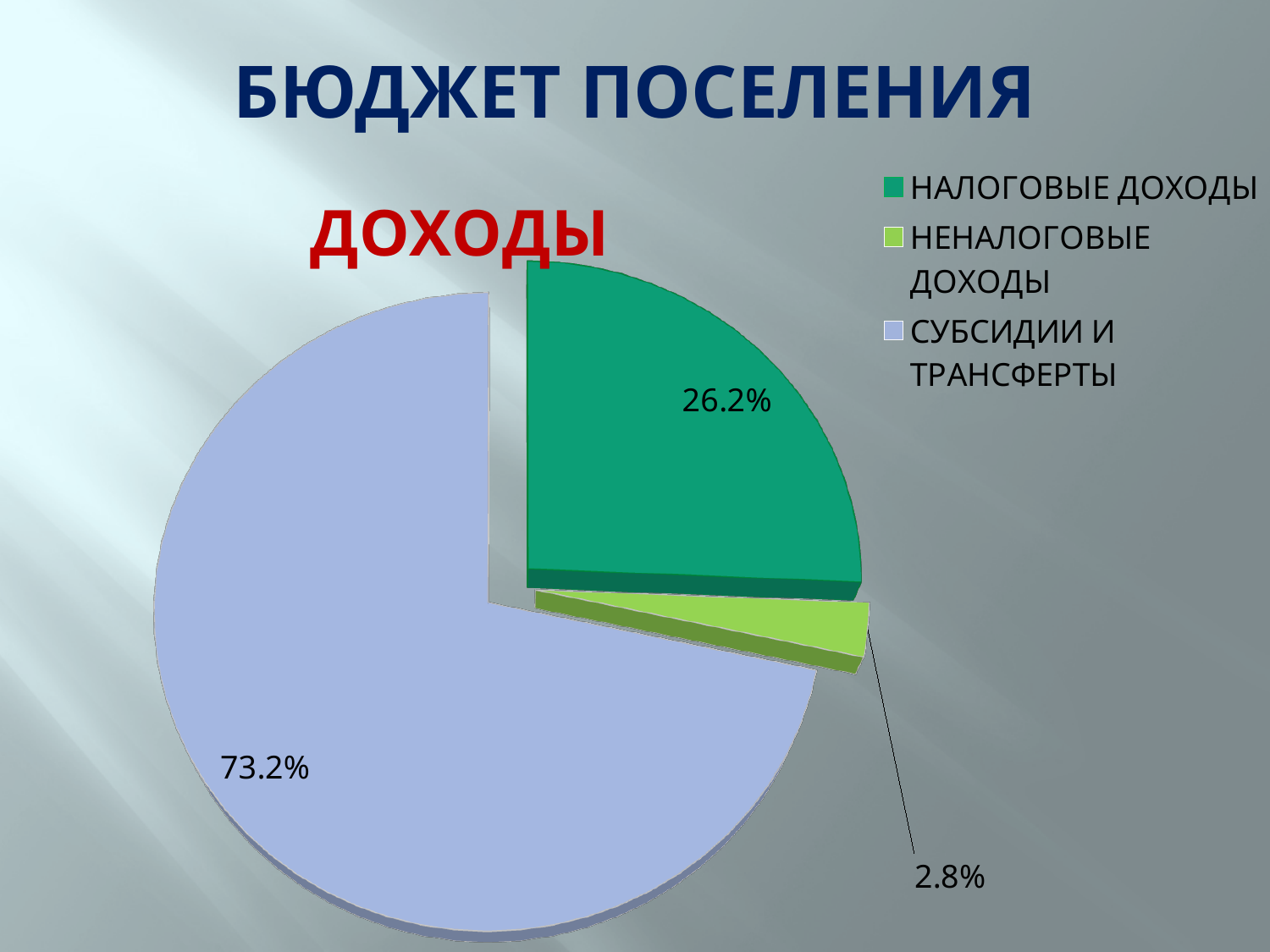
What share of the pie does НЕНАЛОГОВЫЕ ДОХОДЫ represent? 2.8% Which category has the smallest slice of the pie? НЕНАЛОГОВЫЕ ДОХОДЫ What is the difference in percentage points between СУБСИДИИ И ТРАНСФЕРТЫ and НАЛОГОВЫЕ ДОХОДЫ? 47.0% What share of the pie does СУБСИДИИ И ТРАНСФЕРТЫ represent? 73.2% What kind of chart is shown on the slide? pie chart What is the difference in percentage points between НАЛОГОВЫЕ ДОХОДЫ and НЕНАЛОГОВЫЕ ДОХОДЫ? 23.4% How many slices does the pie chart have? 3 Which is larger: НАЛОГОВЫЕ ДОХОДЫ or НЕНАЛОГОВЫЕ ДОХОДЫ? НАЛОГОВЫЕ ДОХОДЫ How many entries does the legend list? 3 Which category has the largest slice of the pie? СУБСИДИИ И ТРАНСФЕРТЫ What is the title of the chart? ДОХОДЫ What share of the pie does НАЛОГОВЫЕ ДОХОДЫ represent? 26.2%